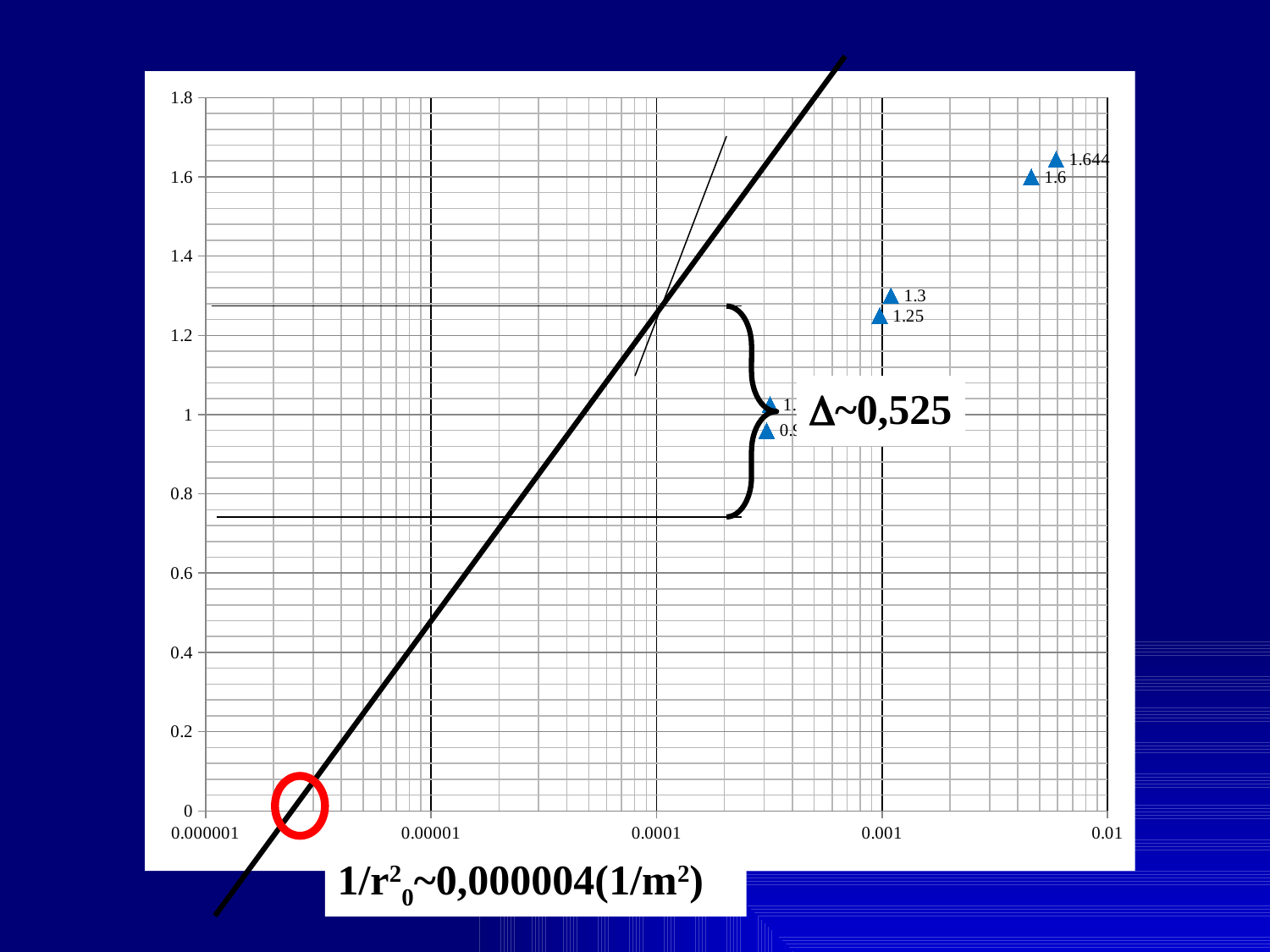
What kind of chart is shown on the slide? scatter chart What value is given for 1/r²₀ in the annotation below the x axis? 0,000004(1/m²) What is the difference between the two labeled points near x = 0.001 (1.3 and 1.25)? 0.05 Do the plotted values rise or fall as x increases along the axis? rise Are the values of the points near x = 0.0003 greater or less than 1.2? less Are the values of the points near x = 0.001 greater or less than 1.2? greater What is the lowest data label shown among the points near x = 0.001? 1.25 Which is larger, the point labeled 1.644 or the point labeled 1.3? 1.644 What is the highest data label shown on the chart? 1.644 What is the difference between the two labeled points near x = 0.005 (1.644 and 1.6)? 0.044 How many data points (triangles) are plotted on the chart? 6 What value is given for Δ in the annotation next to the brace? Δ~0,525